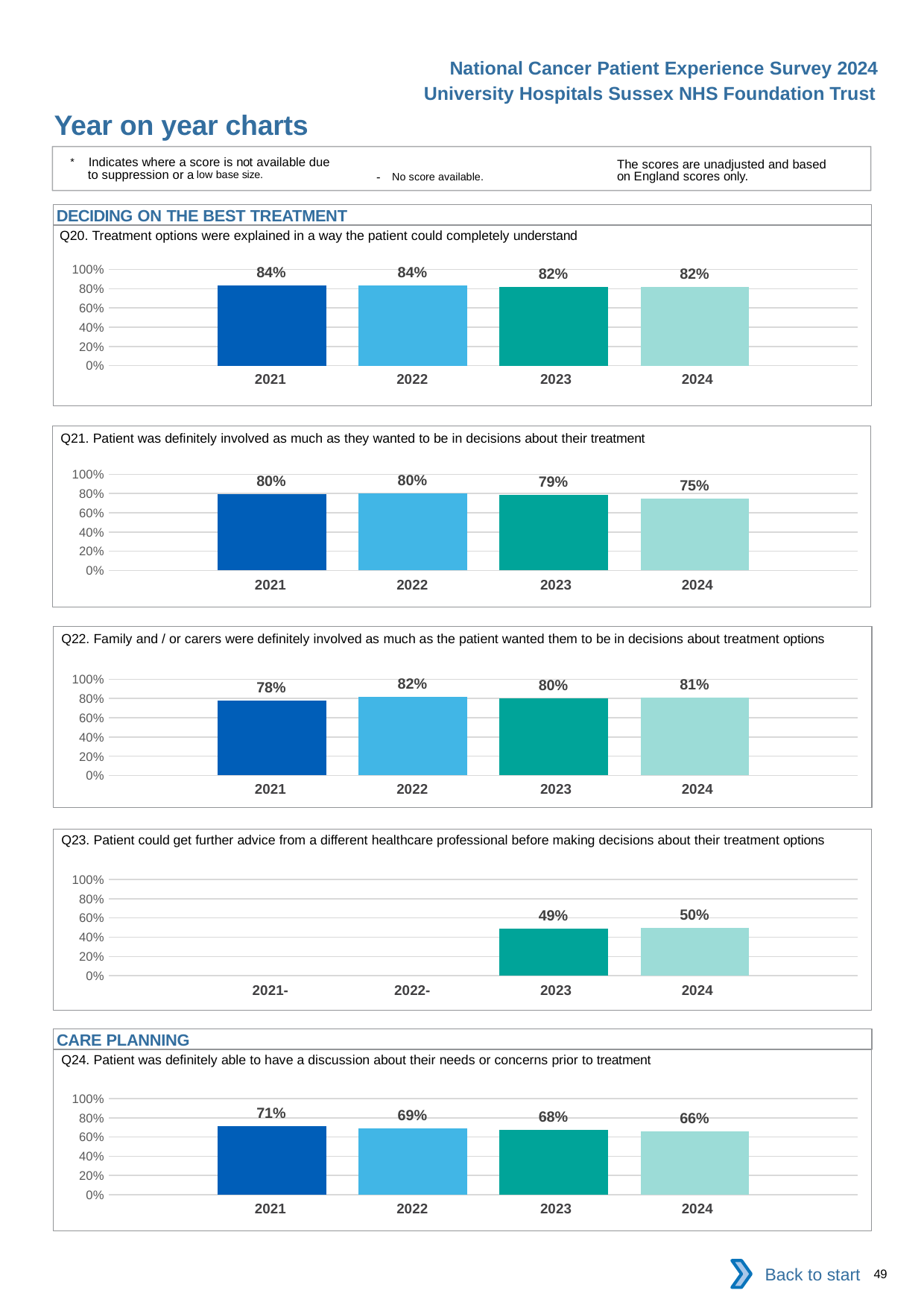
In the Q22 chart, which year has the highest value? 2022 In the Q22 chart, which year has the lowest value? 2021 In the Q24 chart, which is larger, the value for 2021 or the value for 2024? 2021 In the Q23 chart, how many years have a bar plotted? 2 In the Q20 chart, what is the value for 2021? 84% Which section heading appears above the Q24 chart? CARE PLANNING In the Q21 chart, what is the value for 2024? 75% In the Q24 chart, do the values rise or fall from 2021 to 2024? fall In the Q23 chart, what is the value for 2024? 50% What kind of chart is the Q24 chart? bar chart In the Q23 chart, is the value for 2023 greater or less than 60%? less In the Q21 chart, what is the difference between the 2021 value and the 2024 value? 5%